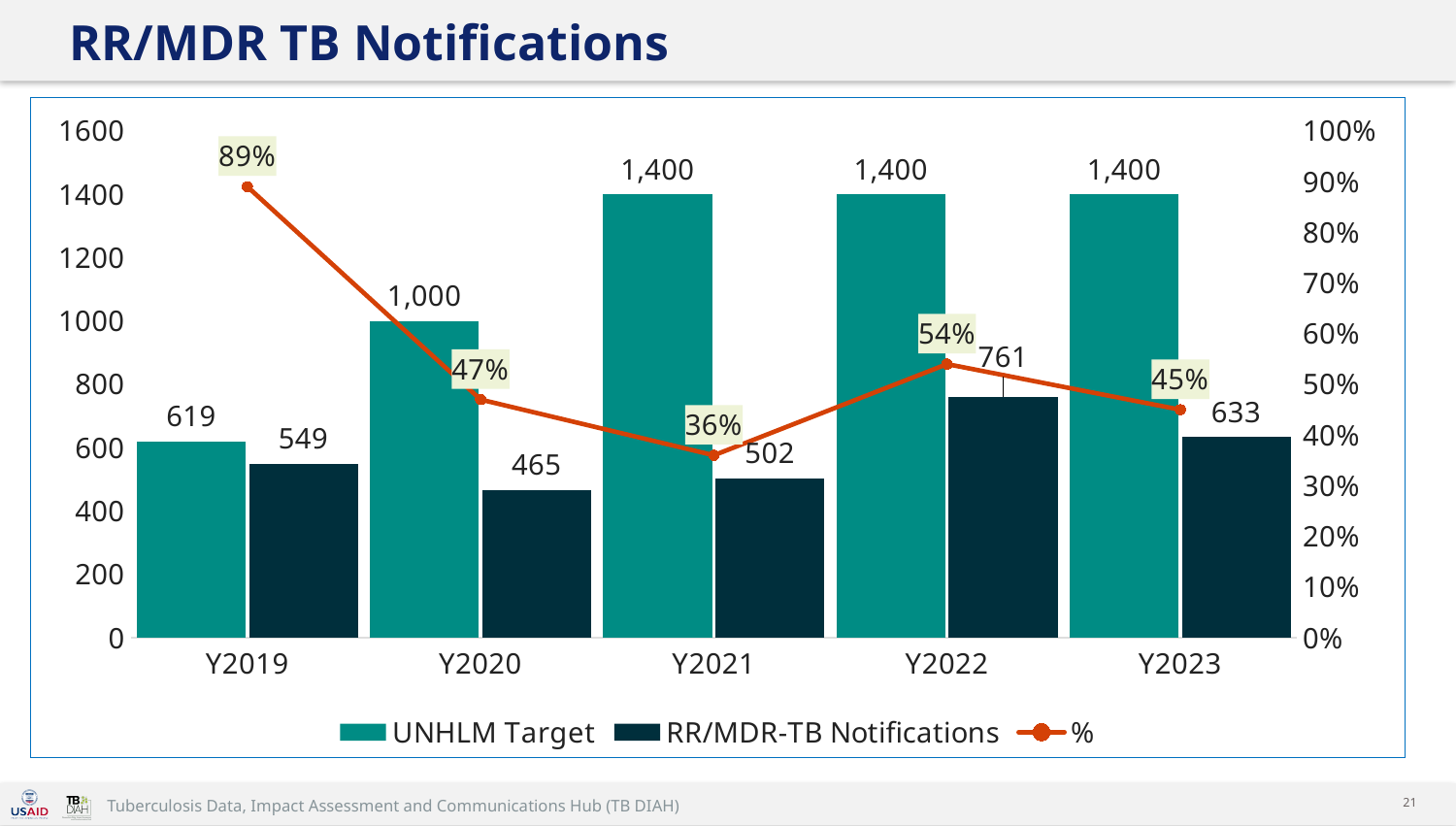
What is the difference between the UNHLM Target and RR/MDR-TB Notifications in Y2023? 767 What is the RR/MDR-TB Notifications value for Y2022? 761 How many series does the legend list? 3 Which year has the highest RR/MDR-TB Notifications value? Y2022 Which is larger, the RR/MDR-TB Notifications value for Y2019 or for Y2020? Y2019 What percentage is shown for Y2019? 89% What kind of chart is this? Combined bar and line chart What is the UNHLM Target value for Y2020? 1,000 Which year has the lowest percentage value on the line? Y2021 Does the percentage line rise or fall from Y2019 to Y2021? Fall What is the title of the chart? RR/MDR TB Notifications How many years are shown on the x axis? 5